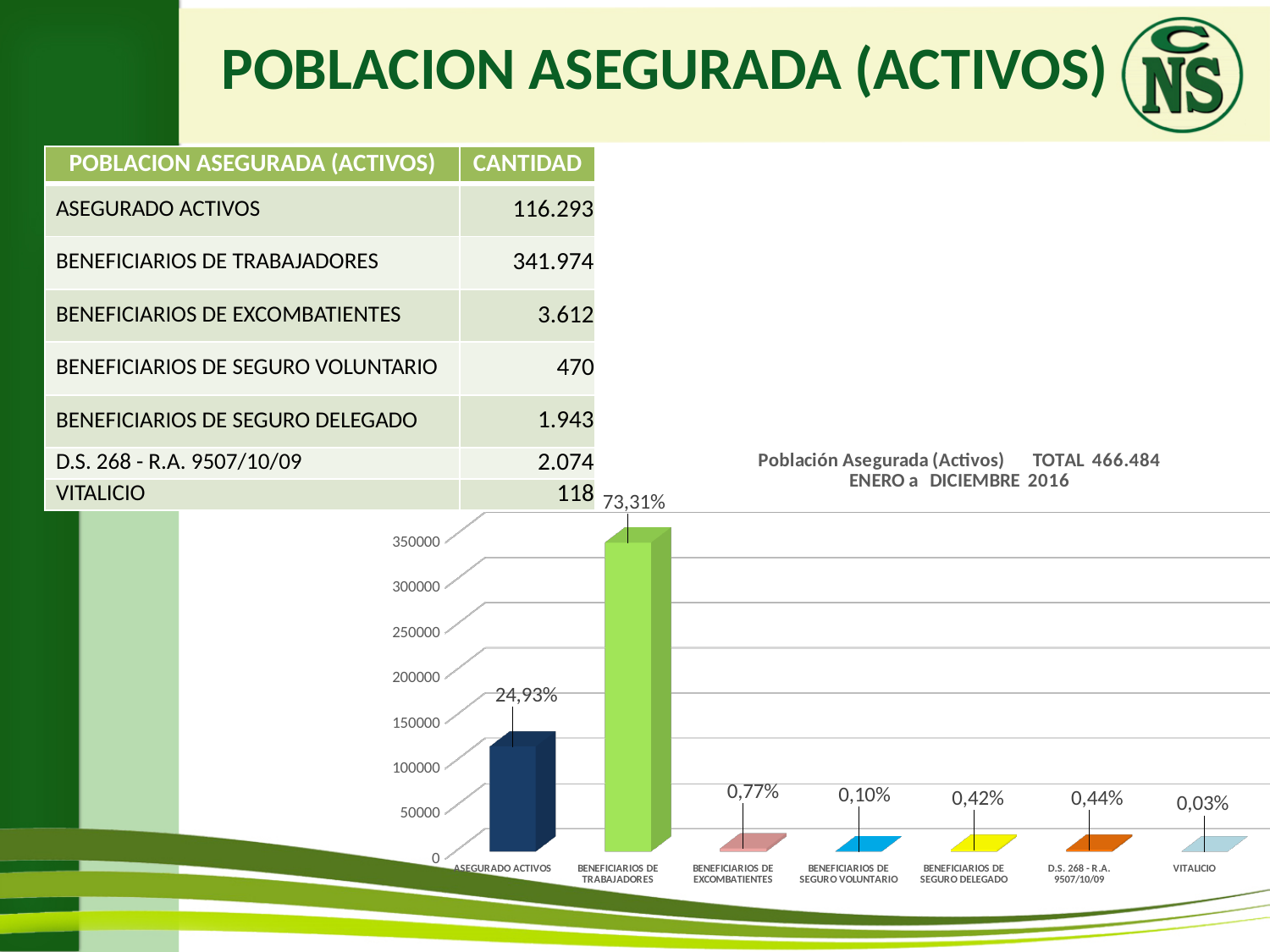
What percentage label is shown on the bar for ASEGURADO ACTIVOS? 24,93% What percentage label is shown on the bar for BENEFICIARIOS DE TRABAJADORES? 73,31% Which bar is taller, BENEFICIARIOS DE TRABAJADORES or ASEGURADO ACTIVOS? BENEFICIARIOS DE TRABAJADORES What percentage label is shown for D.S. 268 - R.A. 9507/10/09? 0,44% Which category has the lowest bar on the chart? VITALICIO What kind of chart is shown on the slide? bar chart What percentage label is shown for VITALICIO? 0,03% How many categories are plotted on the chart? 7 Which category has the highest bar on the chart? BENEFICIARIOS DE TRABAJADORES What is the chart's title? Población Asegurada (Activos) TOTAL 466.484 ENERO a DICIEMBRE 2016 What percentage label is shown for BENEFICIARIOS DE EXCOMBATIENTES? 0,77% Is the bar for ASEGURADO ACTIVOS greater or less than 100000? greater